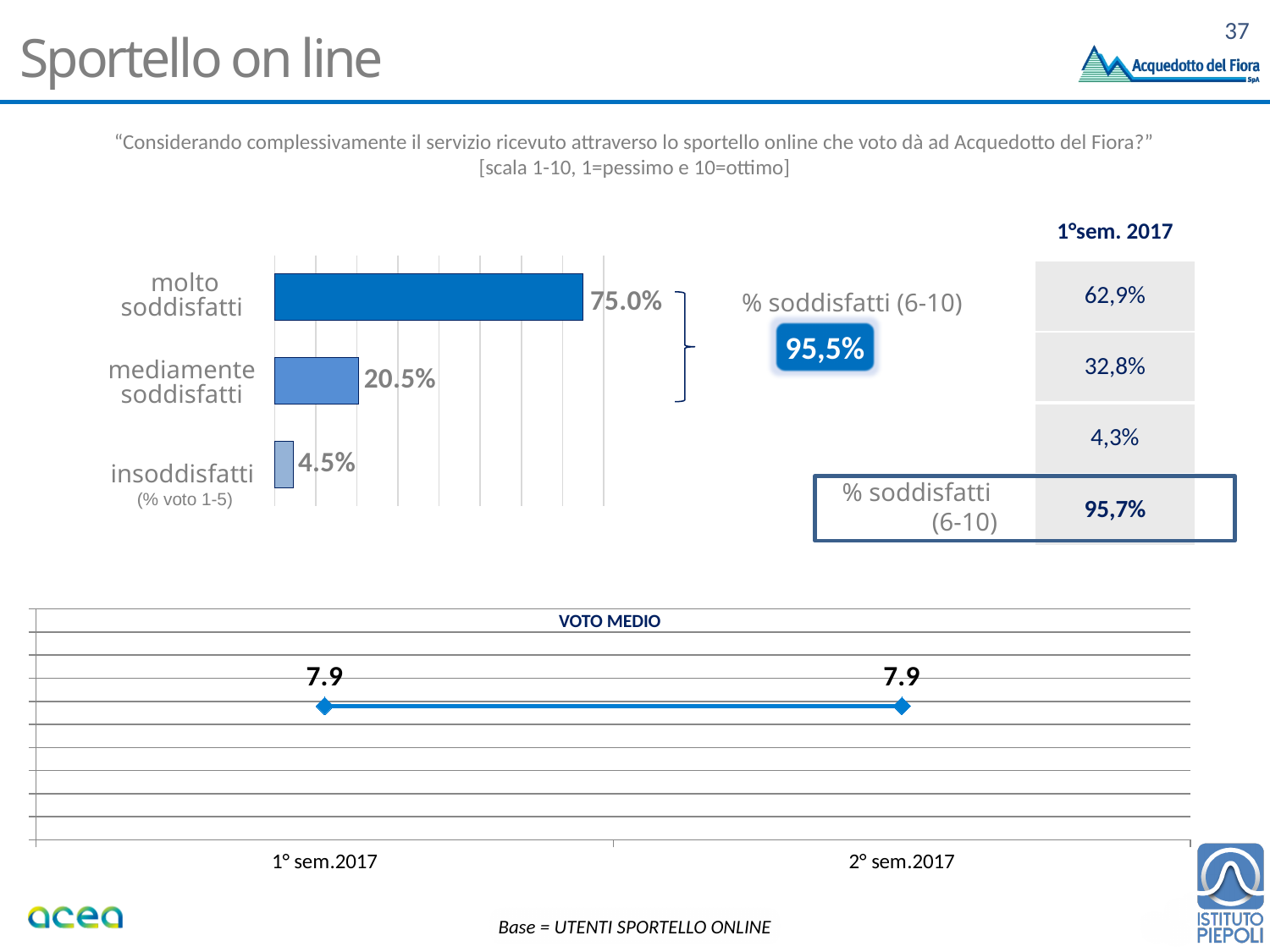
In the bar chart at the top of the slide, what is the value for "insoddisfatti"? 4.5% In the bar chart at the top of the slide, which is larger: the value for "mediamente soddisfatti" or the value for "insoddisfatti"? mediamente soddisfatti In the bar chart at the top of the slide, what is the difference between the values for "molto soddisfatti" and "mediamente soddisfatti"? 54.5% In the bar chart at the top of the slide, what is the value for "mediamente soddisfatti"? 20.5% In the "VOTO MEDIO" chart, what is the value for "2° sem.2017"? 7.9 In the bar chart at the top of the slide, which category has the lowest value? insoddisfatti What kind of chart is the chart at the top left of the slide? bar chart In the "VOTO MEDIO" chart, what is the value for "1° sem.2017"? 7.9 How many categories are shown in the bar chart at the top of the slide? 3 In the "VOTO MEDIO" chart, do the values rise, fall or stay the same from "1° sem.2017" to "2° sem.2017"? stay the same In the bar chart at the top of the slide, which category has the highest value? molto soddisfatti In the bar chart at the top of the slide, what is the value for "molto soddisfatti"? 75.0%